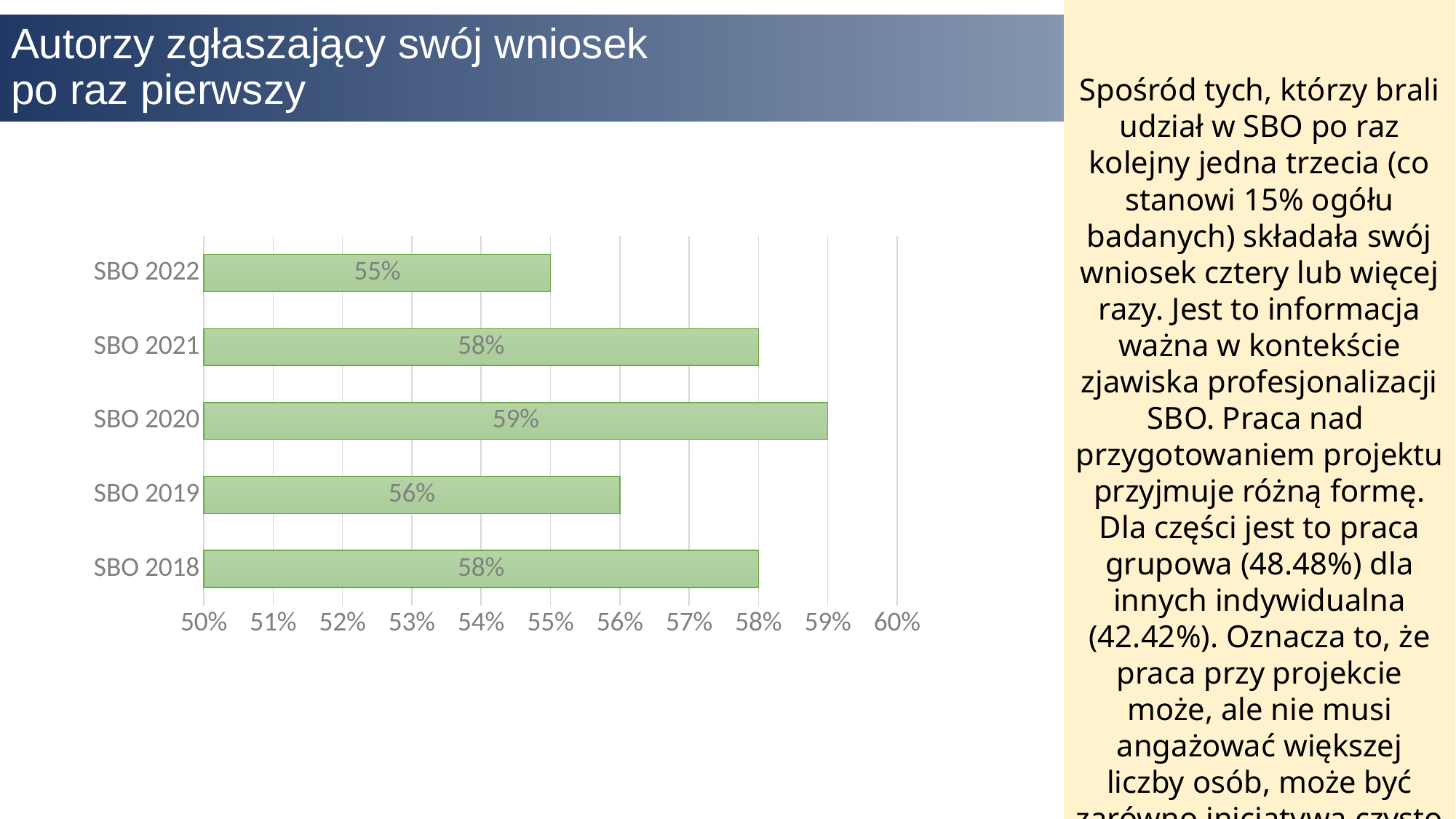
What is the value for SBO 2019? 56% What kind of chart is shown on the slide? bar chart Which is larger, the value for SBO 2021 or the value for SBO 2019? SBO 2021 What is the title of the slide containing the chart? Autorzy zgłaszający swój wniosek po raz pierwszy What is the value for SBO 2018? 58% How many categories are shown in the chart? 5 What is the difference between the values for SBO 2020 and SBO 2022? 4% Is the value for SBO 2018 greater or less than 57%? greater What is the value for SBO 2022? 55% Which category has the highest value? SBO 2020 What is the value for SBO 2020? 59% Which category has the lowest value? SBO 2022